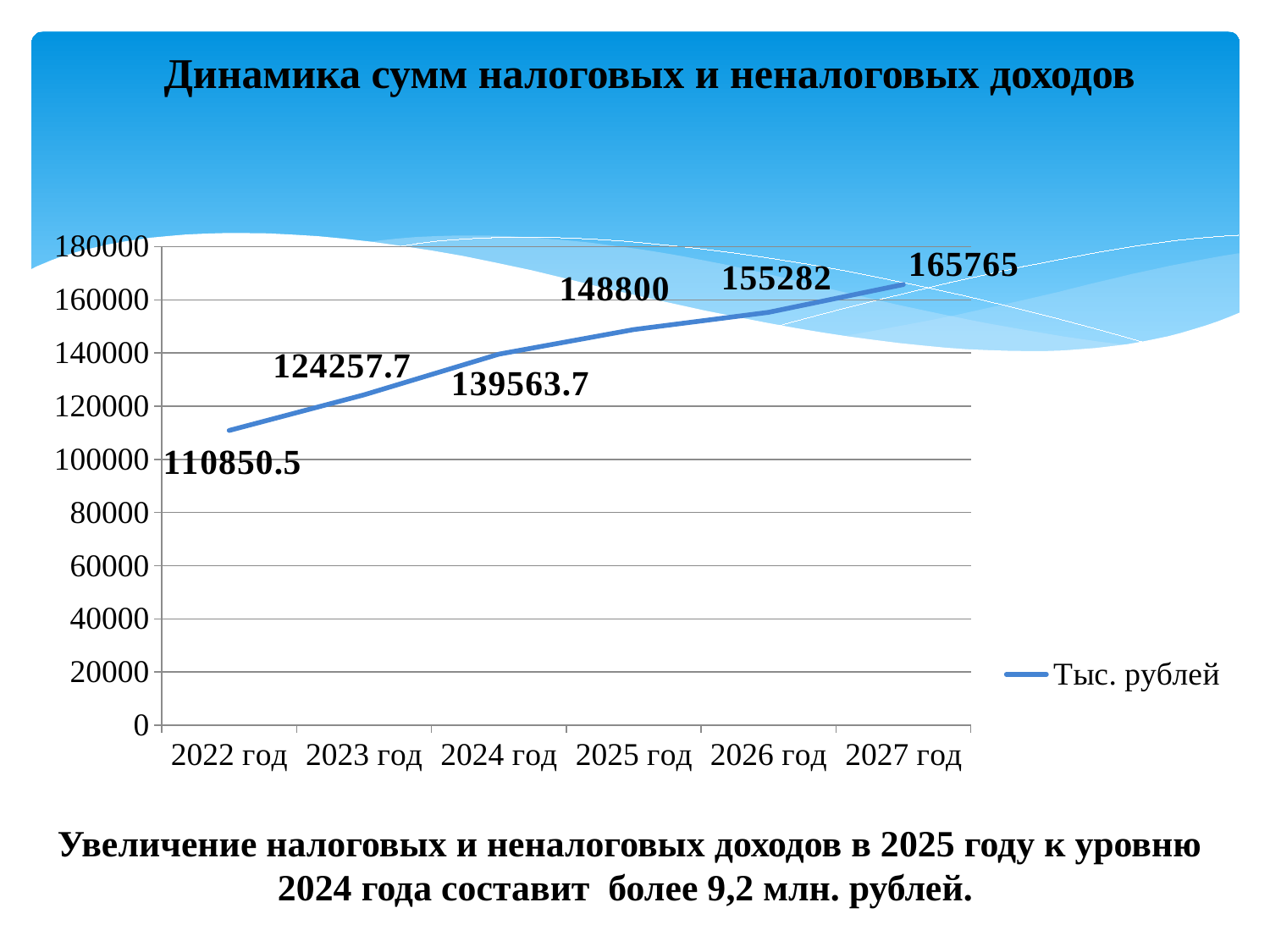
What is the value for 2022 год? 110850.5 Which year has the lowest value? 2022 год Do the values rise or fall from 2022 год to 2027 год? rise Which is larger, the value for 2023 год or the value for 2026 год? 2026 год What is the difference between the values for 2025 год and 2024 год? 9236.3 What kind of chart is shown on the slide? line chart Which year has the highest value? 2027 год What is the value for 2025 год? 148800 What is the difference between the values for 2027 год and 2022 год? 54914.5 Is the value for 2024 год greater or less than 120000? greater What is the value for 2027 год? 165765 How many years are plotted on the chart? 6